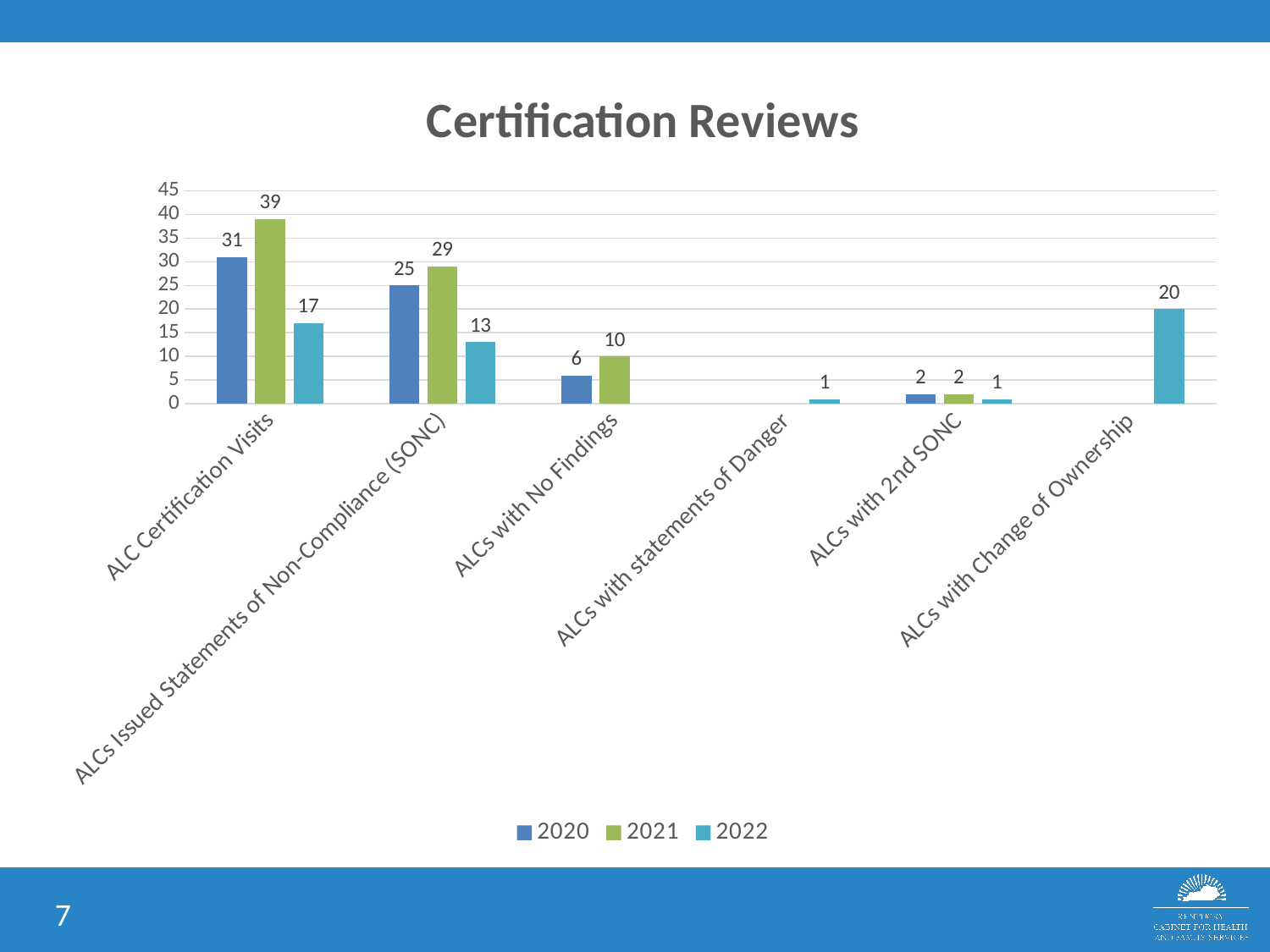
What is the total of the 2020, 2021 and 2022 values for ALCs with 2nd SONC? 5 What kind of chart is shown on the slide? Bar chart Which category has the highest value for the 2020 series? ALC Certification Visits What is the value for 2022 in the ALCs with Change of Ownership category? 20 What is the title of the chart? Certification Reviews What is the difference between the 2021 and 2022 values for ALC Certification Visits? 22 How many categories are shown on the x axis? 6 How many series does the legend list? 3 Which is larger for ALCs with No Findings: the 2020 value or the 2021 value? 2021 What is the value for 2021 in the ALC Certification Visits category? 39 What is the value for 2020 in the ALCs Issued Statements of Non-Compliance (SONC) category? 25